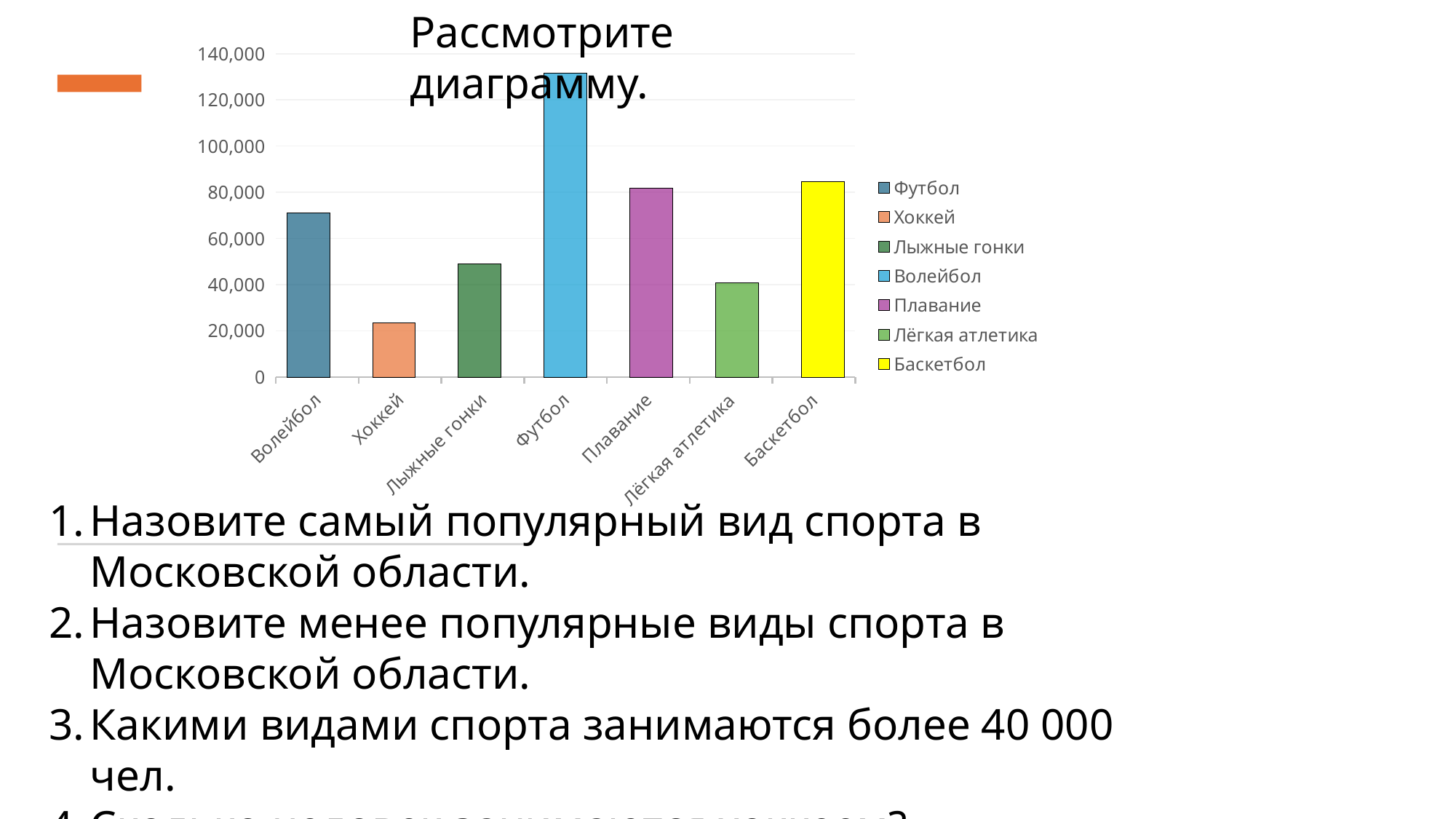
Is the value for Хоккей greater or less than 40,000? less How many entries does the chart's legend list? 7 Is the value for Лёгкая атлетика greater or less than 60,000? less Which is larger, the value for Лыжные гонки or the value for Лёгкая атлетика? Лыжные гонки How many categories are shown on the x axis of the chart? 7 Is the value for Волейбол greater or less than 60,000? greater Which category has the highest bar in the chart? Футбол What kind of chart is shown on the slide? bar chart Which is larger, the value for Волейбол or the value for Плавание? Плавание Which category has the lowest bar in the chart? Хоккей What colour is the bar for Баскетбол in the chart? yellow